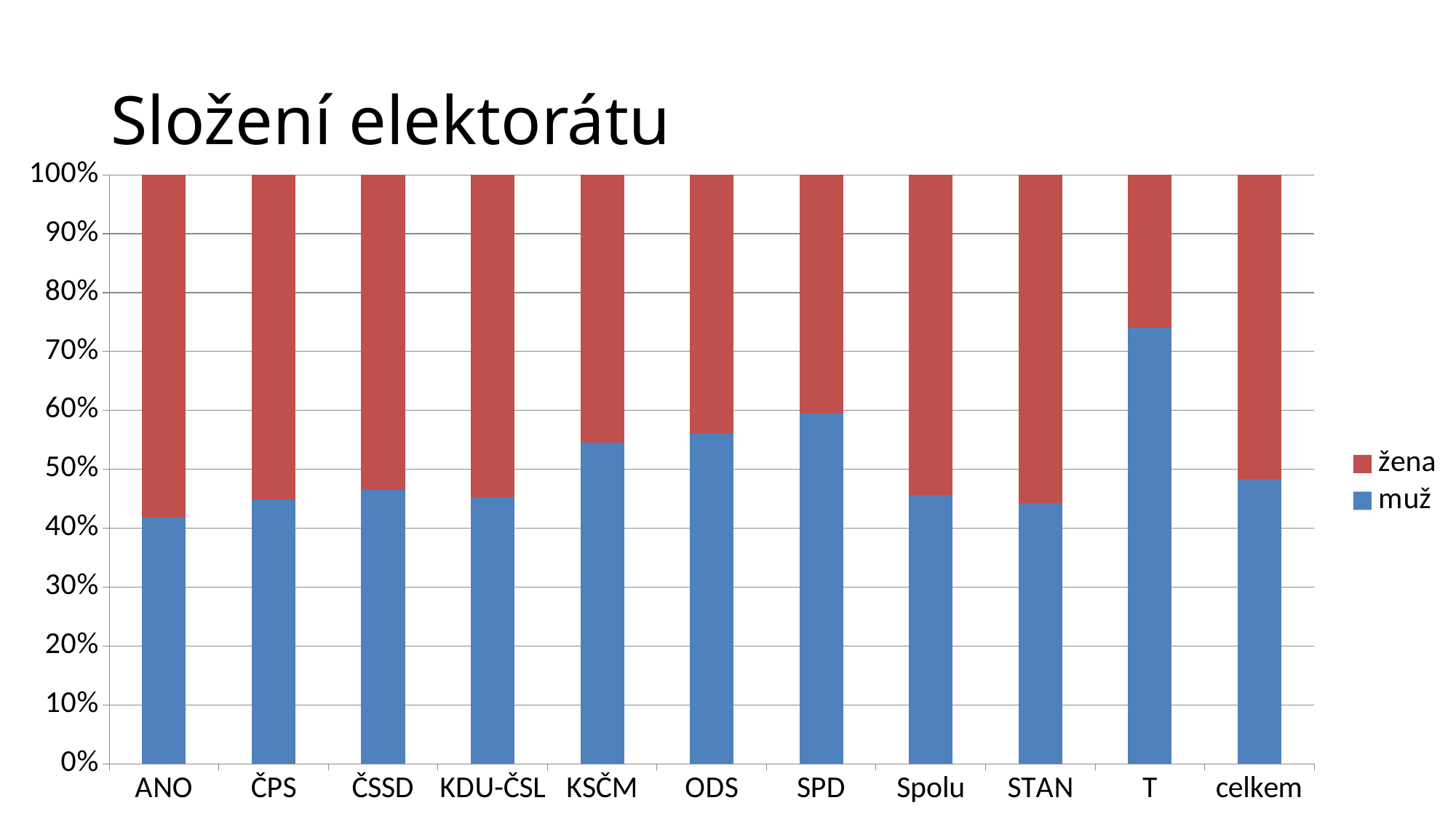
Is the "muž" share for ANO greater or less than 50%? less What kind of chart is shown on the slide? stacked bar chart Which category has the highest share of "muž"? T Is the "muž" share for SPD greater or less than 50%? greater What is the title of the chart? Složení elektorátu Which has a larger "žena" share, ANO or KSČM? ANO How many categories are shown on the x axis? 11 Which category has the lowest share of "muž"? ANO Which has a larger "muž" share, ODS or STAN? ODS How many series does the legend list? 2 Which colour represents the series "muž"? blue Is the "muž" share for T greater or less than 70%? greater